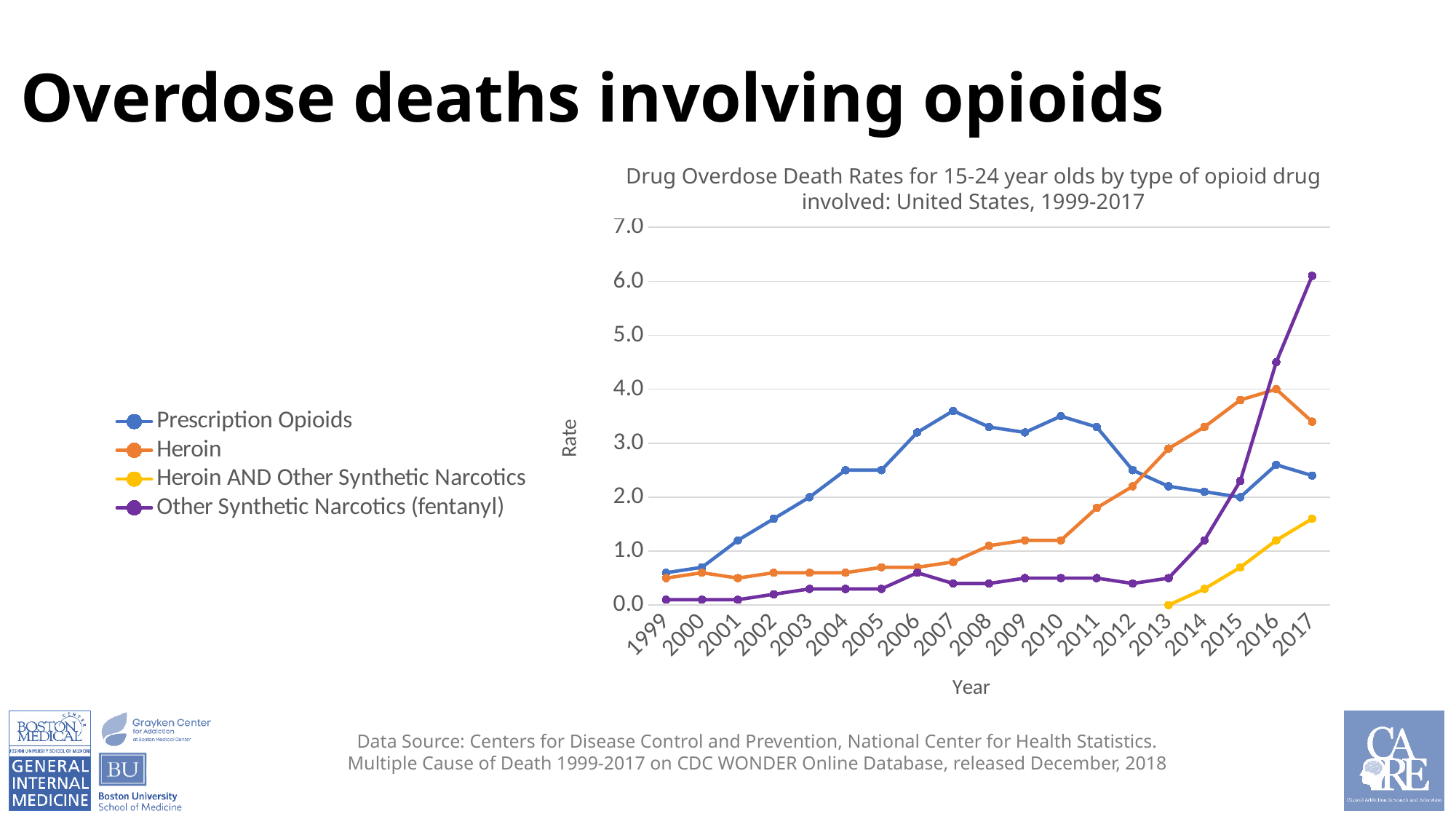
Is the rate for Prescription Opioids in 2007 greater or less than 3.0? greater Is the rate for Other Synthetic Narcotics (fentanyl) in 2017 greater or less than 5.0? greater How many years are plotted along the x axis? 19 How many series does the legend list? 4 Is the rate for Heroin in 2017 greater or less than 3.0? greater Does the rate for Other Synthetic Narcotics (fentanyl) rise or fall from 2013 to 2017? rise In 2016, which series has the higher rate, Heroin or Prescription Opioids? Heroin What colour is the Heroin line in the chart? orange What kind of chart is shown on the slide? line chart In 2007, which series has the higher rate, Prescription Opioids or Heroin? Prescription Opioids Which series has the lowest rate in 2013? Heroin AND Other Synthetic Narcotics Which series has the highest rate in 2017? Other Synthetic Narcotics (fentanyl)